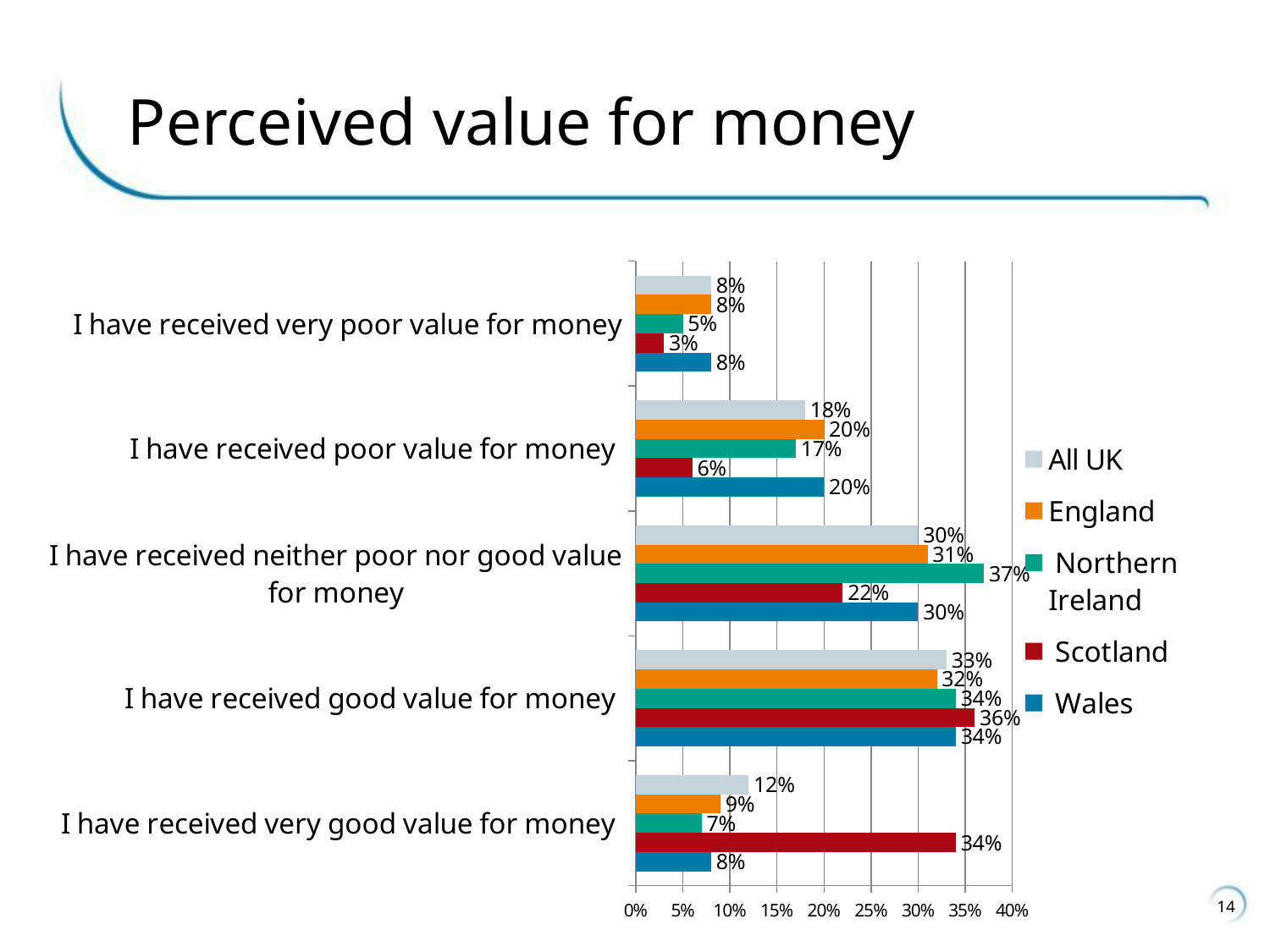
Is the Northern Ireland value for 'I have received neither poor nor good value for money' greater or less than 35%? greater Which series has the highest value for 'I have received very good value for money'? Scotland For 'I have received poor value for money', which is larger: the England value or the Scotland value? England What is the difference between the Scotland and All UK values for 'I have received very good value for money'? 22% What is the value for Wales for 'I have received poor value for money'? 20% How many categories (statements) are shown on the chart? 5 What kind of chart is shown on the slide? Bar chart Which series has the lowest value for 'I have received very poor value for money'? Scotland What is the title of the slide containing the chart? Perceived value for money What is the value for Northern Ireland for 'I have received neither poor nor good value for money'? 37% What is the value for Scotland for 'I have received very good value for money'? 34% How many series does the legend list? 5